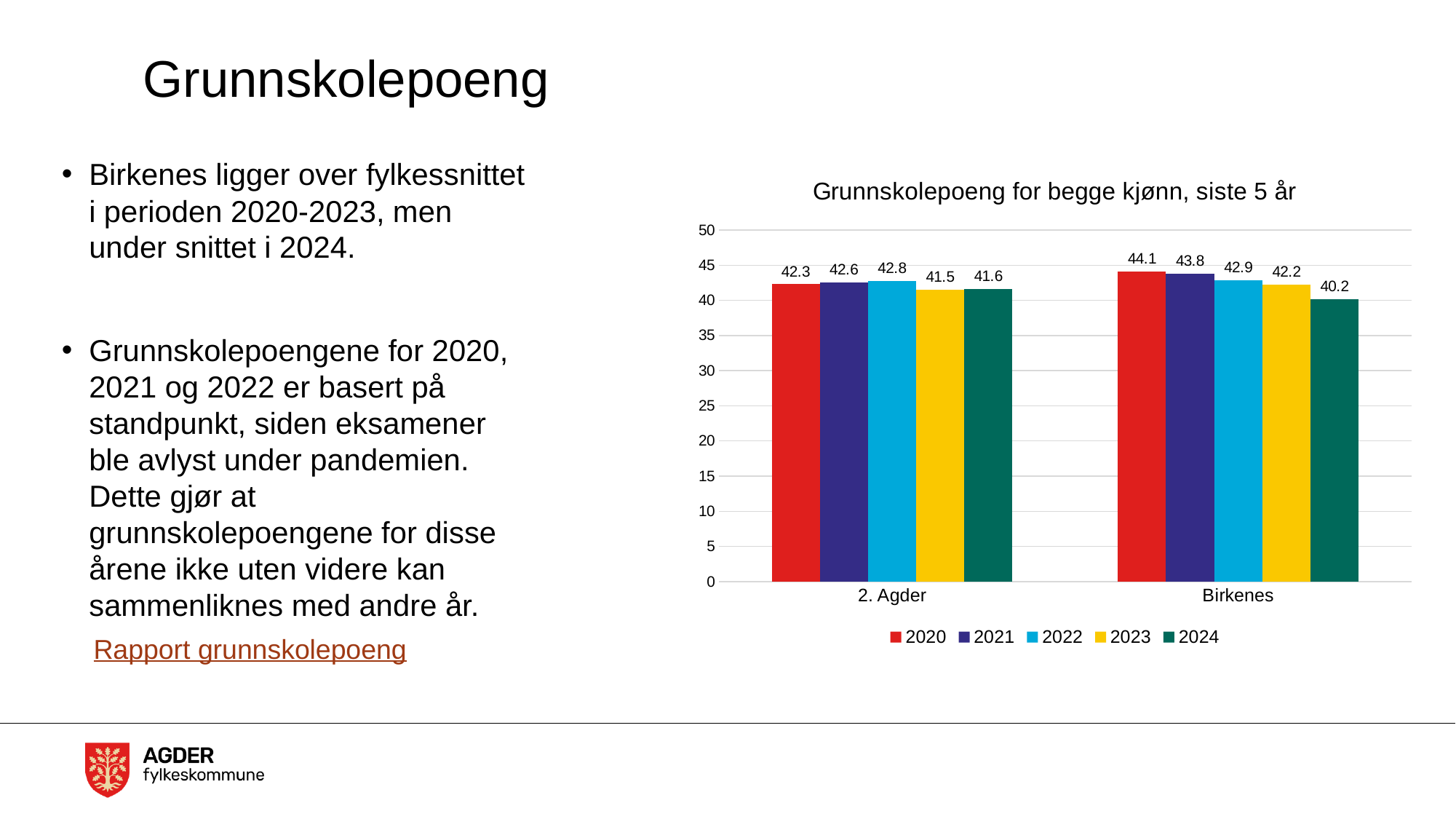
What is the difference between the Birkenes and 2. Agder values in 2020? 1.8 What is the value for Birkenes in 2023? 42.2 Is the value for Birkenes in 2024 greater or less than 45? less Which year has the lowest value for 2. Agder? 2023 Which is larger in 2024, the value for 2. Agder or for Birkenes? 2. Agder What is the value for Birkenes in 2020? 44.1 Do the values for Birkenes rise or fall from 2020 to 2024? fall What kind of chart is shown? bar chart Which year has the highest value for Birkenes? 2020 How many categories are shown on the x axis? 2 How many series does the legend list? 5 What is the value for 2. Agder in 2024? 41.6